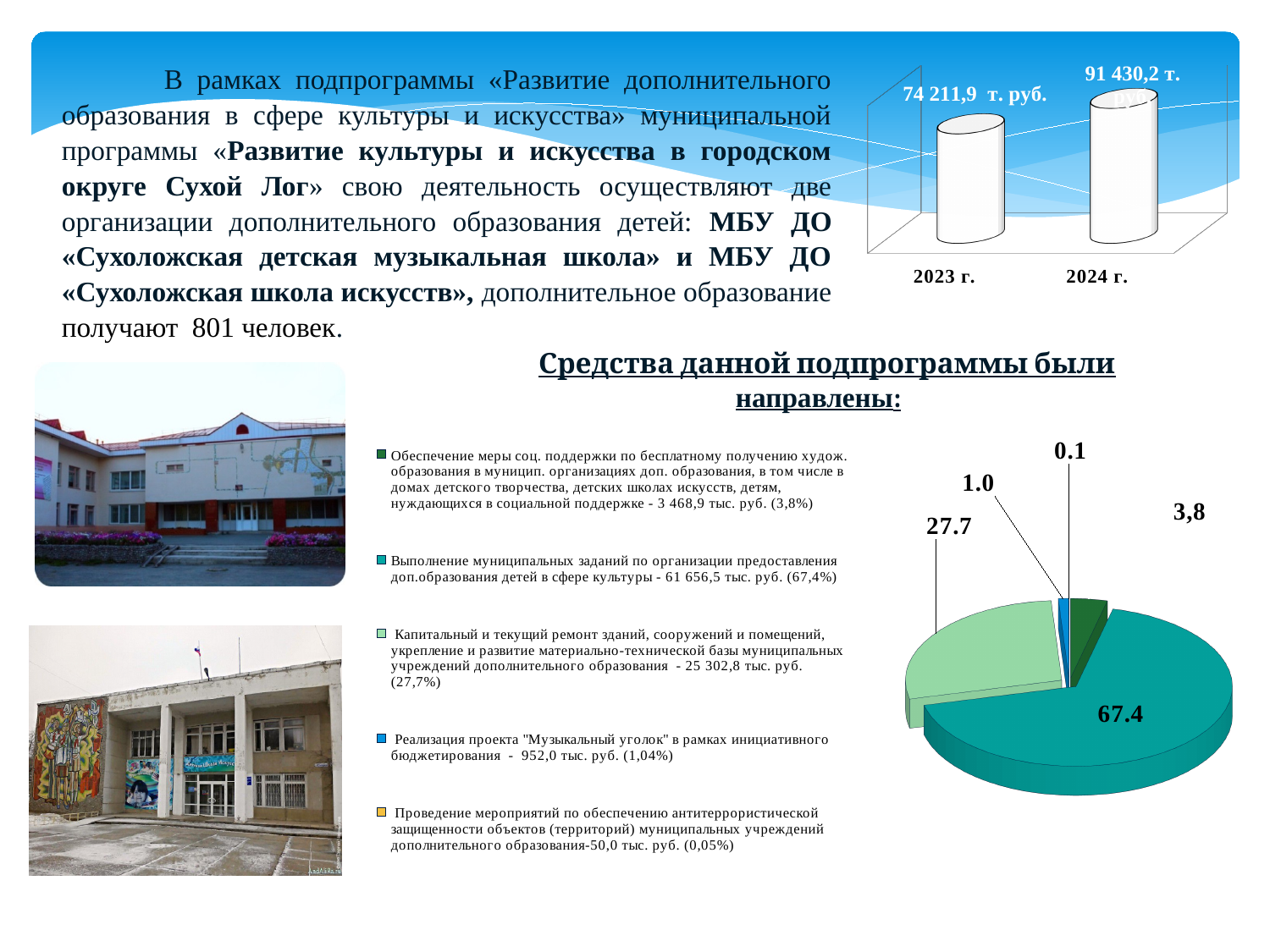
In the bar chart at the top right of the slide, which year has the higher value? 2024 г. How many entries does the legend of the pie chart under the heading «Средства данной подпрограммы были направлены:» list? 5 What kind of chart is shown at the top right of the slide? bar chart How many categories are shown in the bar chart at the top right of the slide? 2 In the pie chart under the heading «Средства данной подпрограммы были направлены:», what is the largest slice's value? 67.4 In the bar chart at the top right of the slide, do the values rise or fall from 2023 г. to 2024 г.? rise In the bar chart at the top right of the slide, by how much does the 2024 г. value exceed the 2023 г. value? 17 218,3 т. руб. In the bar chart at the top right of the slide, what is the value for 2023 г.? 74 211,9 т. руб. How many slices does the pie chart under the heading «Средства данной подпрограммы были направлены:» have? 5 In the bar chart at the top right of the slide, what is the value for 2024 г.? 91 430,2 т. руб. In the pie chart under the heading «Средства данной подпрограммы были направлены:», what is the smallest slice's value? 0.1 In the pie chart under the heading «Средства данной подпрограммы были направлены:», what value is labelled for the slice representing «Капитальный и текущий ремонт зданий, сооружений и помещений...»? 27.7